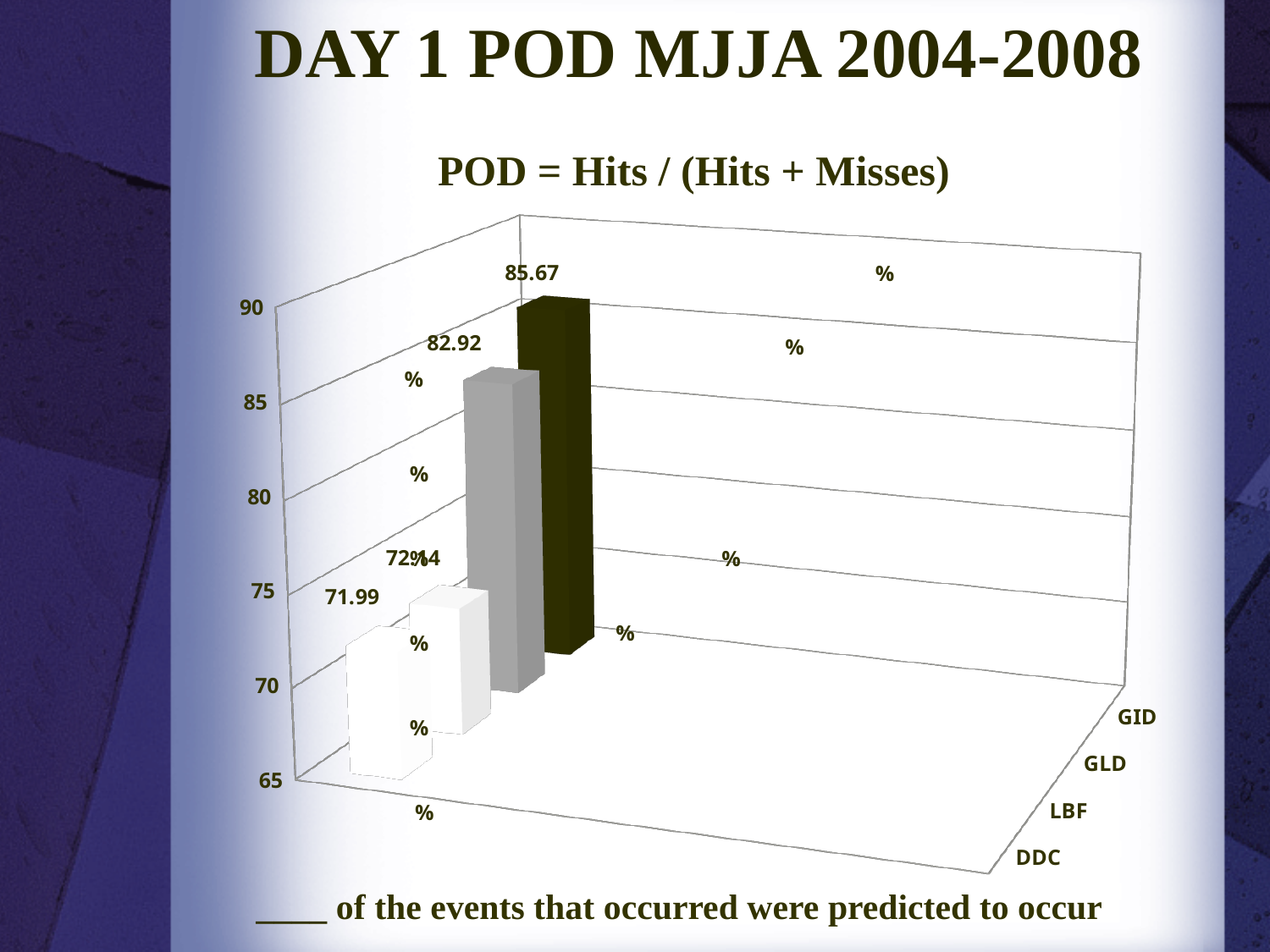
What kind of chart is shown on the slide? bar chart What is the POD value for GLD? 82.92 Do the POD values rise or fall going from DDC to GID? rise How many categories are plotted on the chart? 4 Is the POD value for DDC greater or less than 75? less What is the POD value for GID? 85.67 What is the title of the chart? POD = Hits / (Hits + Misses) Which has a larger POD value, GLD or GID? GID Which category has the highest POD value? GID What is the difference between the POD values for GID and DDC? 13.68 What is the difference between the POD values for GID and GLD? 2.75 What is the POD value for DDC? 71.99